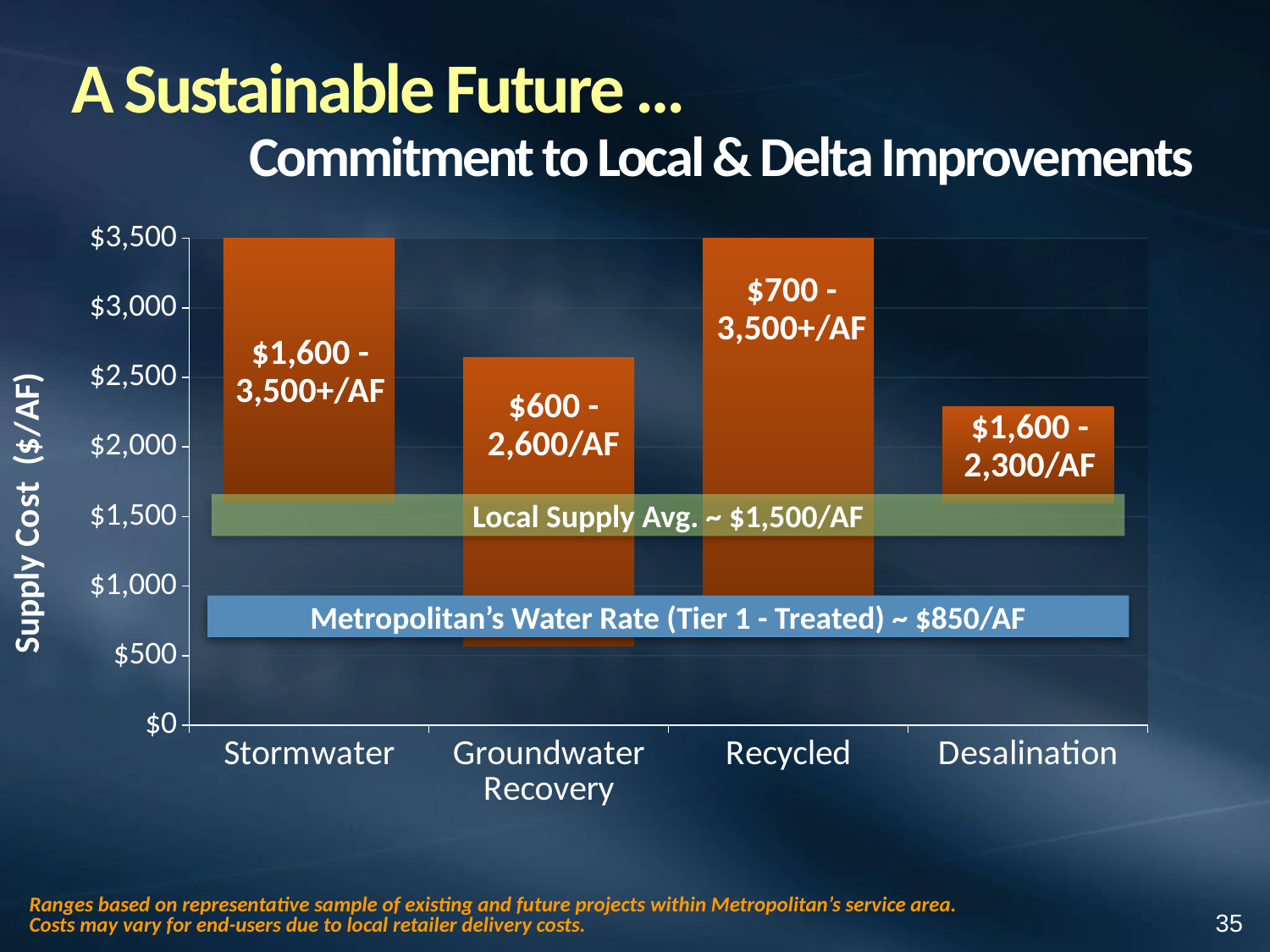
What cost range is labeled on the Stormwater bar? $1,600 - 3,500+/AF What is the difference between the high-end and low-end costs in the Desalination range? $700 Which supply type has the lowest low-end cost in its labeled range? Groundwater Recovery Which supply type has the lowest high-end cost in its labeled range? Desalination How many supply types are shown on the x axis? 4 What cost range is labeled on the Groundwater Recovery bar? $600 - 2,600/AF What kind of chart is shown on the slide? Bar chart Is the top of the Desalination bar greater or less than $2,500? less What cost range is labeled on the Desalination bar? $1,600 - 2,300/AF What value is given for Metropolitan's Water Rate (Tier 1 - Treated) in the horizontal band? ~ $850/AF What cost range is labeled on the Recycled bar? $700 - 3,500+/AF Which is larger, the high-end cost for Groundwater Recovery or the high-end cost for Desalination? Groundwater Recovery